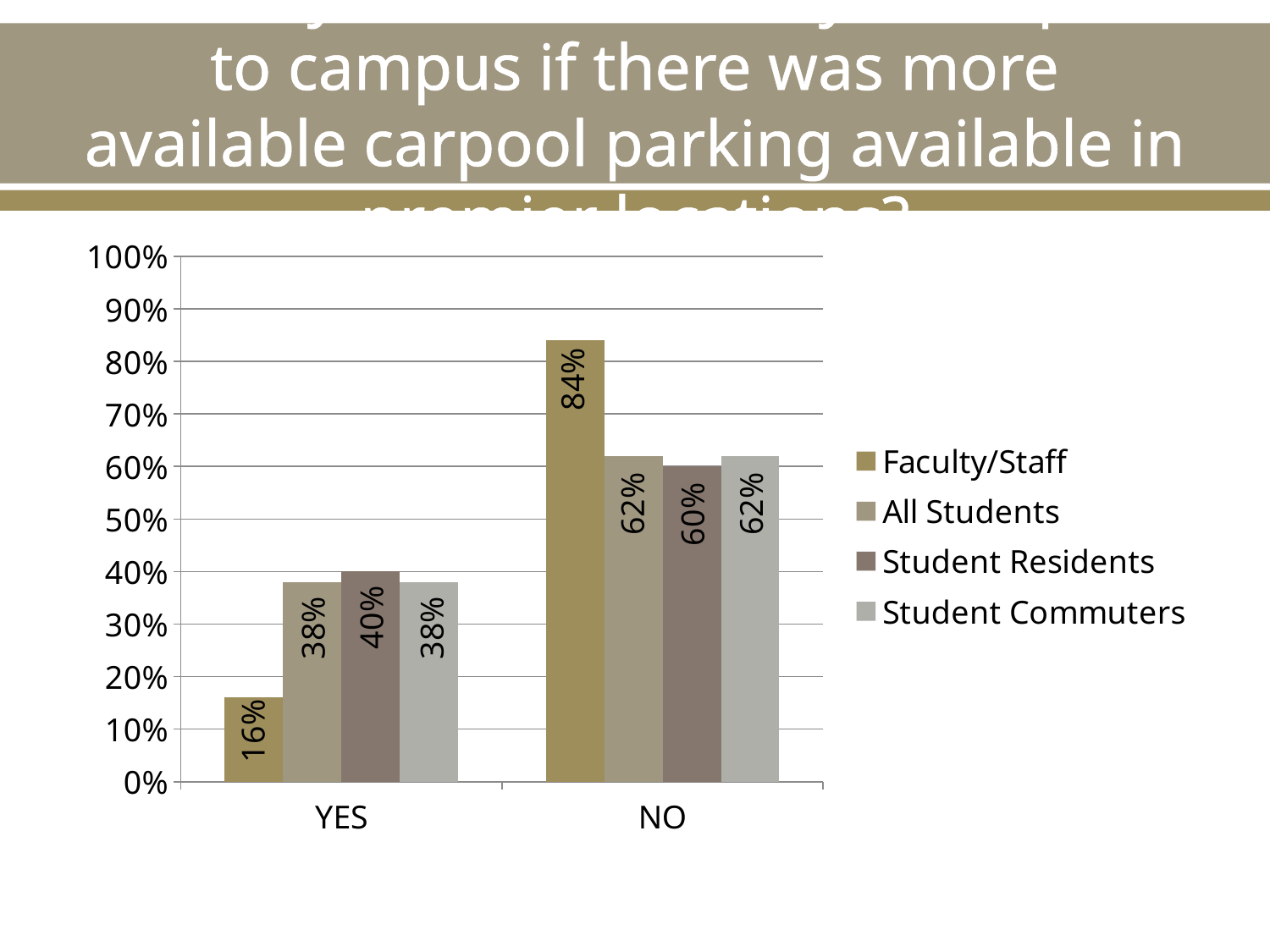
What percentage of Student Residents answered NO? 60% Which group has the highest value for NO? Faculty/Staff What percentage of All Students answered YES? 38% What percentage of Faculty/Staff answered YES? 16% Which is larger: Student Residents for YES or All Students for YES? Student Residents Which legend entry is listed last? Student Commuters How many categories are shown on the x axis? 2 How many series does the legend list? 4 Which group has the lowest value for YES? Faculty/Staff What is the difference between the Faculty/Staff NO value and the Faculty/Staff YES value? 68% What is the difference between the Student Commuters NO value and the Student Residents NO value? 2% What kind of chart is shown on the slide? Bar chart